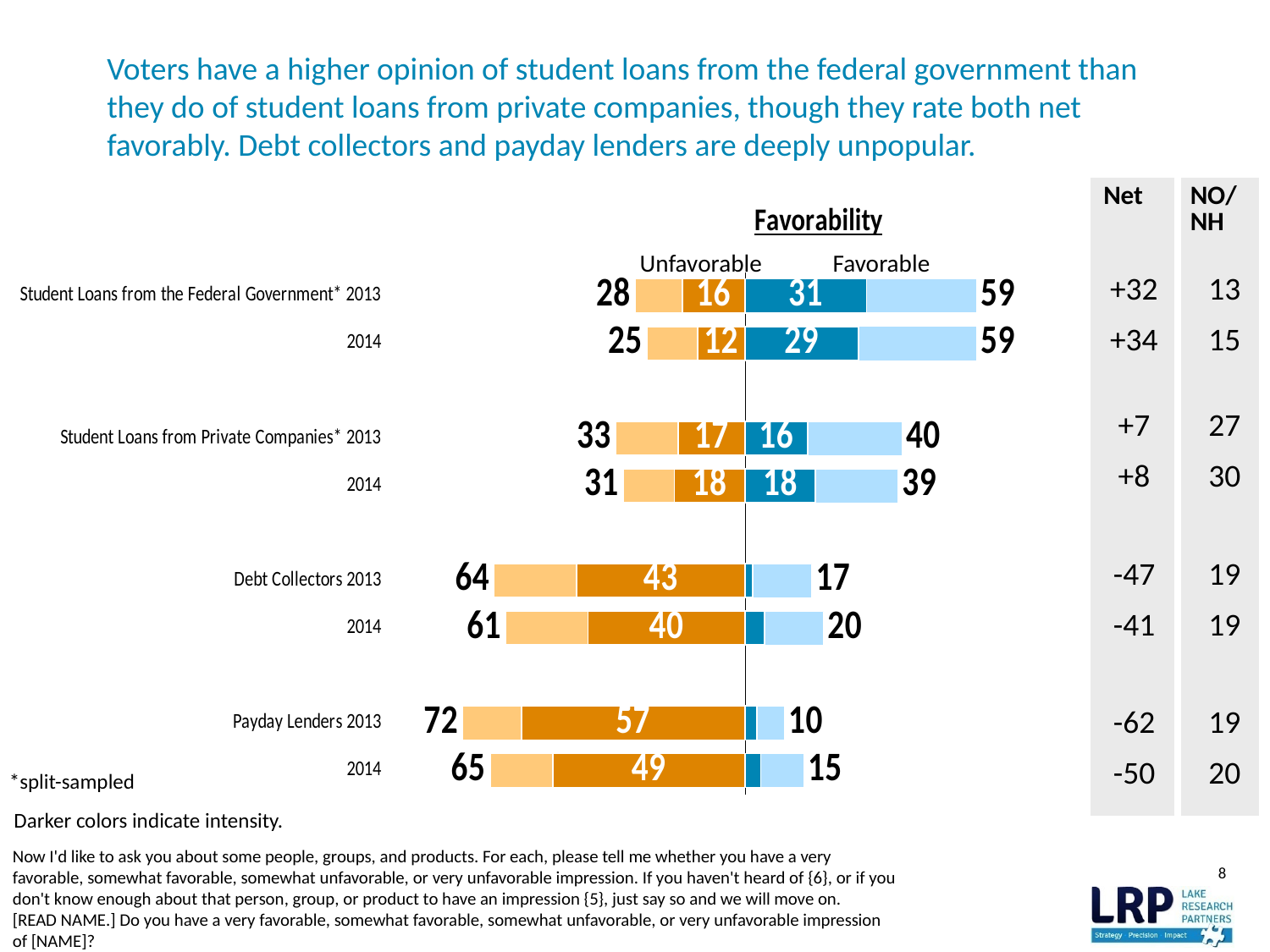
What kind of chart is shown on the slide? Bar chart Which item and year has the highest total unfavorable percentage? Payday Lenders 2013 What is the difference between the total favorable and total unfavorable percentages for Student Loans from Private Companies in 2013? 7 Which item and year has the lowest total favorable percentage? Payday Lenders 2013 What is the total unfavorable percentage for Payday Lenders in 2013? 72 Which is larger: the total unfavorable percentage for Debt Collectors in 2013 or for Debt Collectors in 2014? Debt Collectors 2013 What is the very unfavorable (darker orange) value for Debt Collectors in 2014? 40 What is the Net value shown for Payday Lenders in 2014? -50 What is the title of the chart? Favorability What is the very favorable (darker blue) value for Student Loans from the Federal Government in 2013? 31 What is the total favorable percentage for Student Loans from the Federal Government in 2014? 59